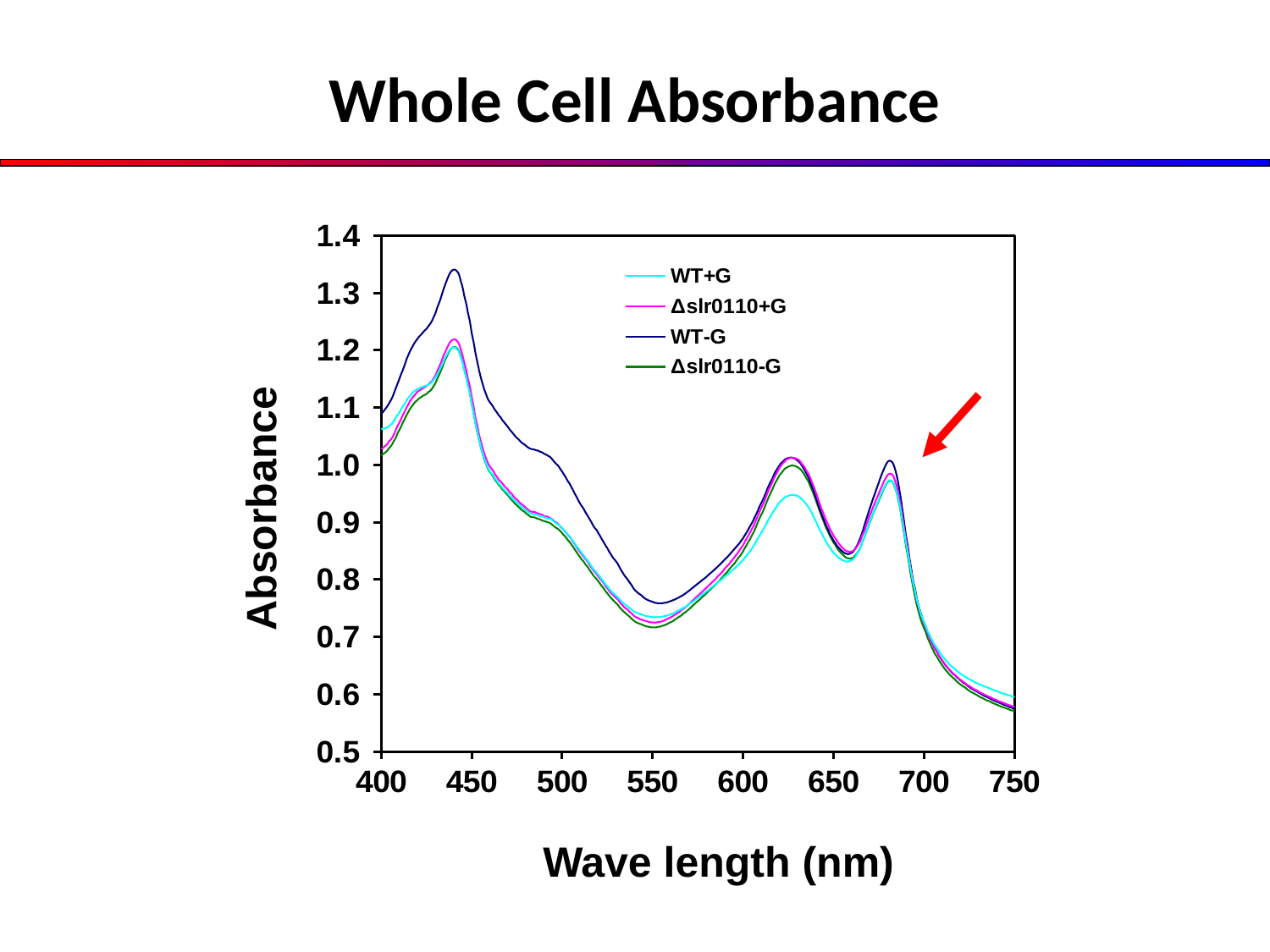
Which series has the highest absorbance at the peak near 440 nm? WT-G At 440 nm, which has the larger absorbance, WT-G or WT+G? WT-G Is the WT+G absorbance at 550 nm greater or less than 0.8? less Is the WT-G absorbance at 500 nm greater or less than 0.9? greater Is the WT-G absorbance at 750 nm greater or less than 0.7? less How many series does the legend list? 4 What are the four series named in the legend? WT+G, Δslr0110+G, WT-G, Δslr0110-G What kind of chart is shown on the slide? line chart Which series has the lowest absorbance at the peak near 625 nm? WT+G Does the WT-G absorbance rise or fall between 450 nm and 550 nm? fall What is the label of the x axis? Wave length (nm)